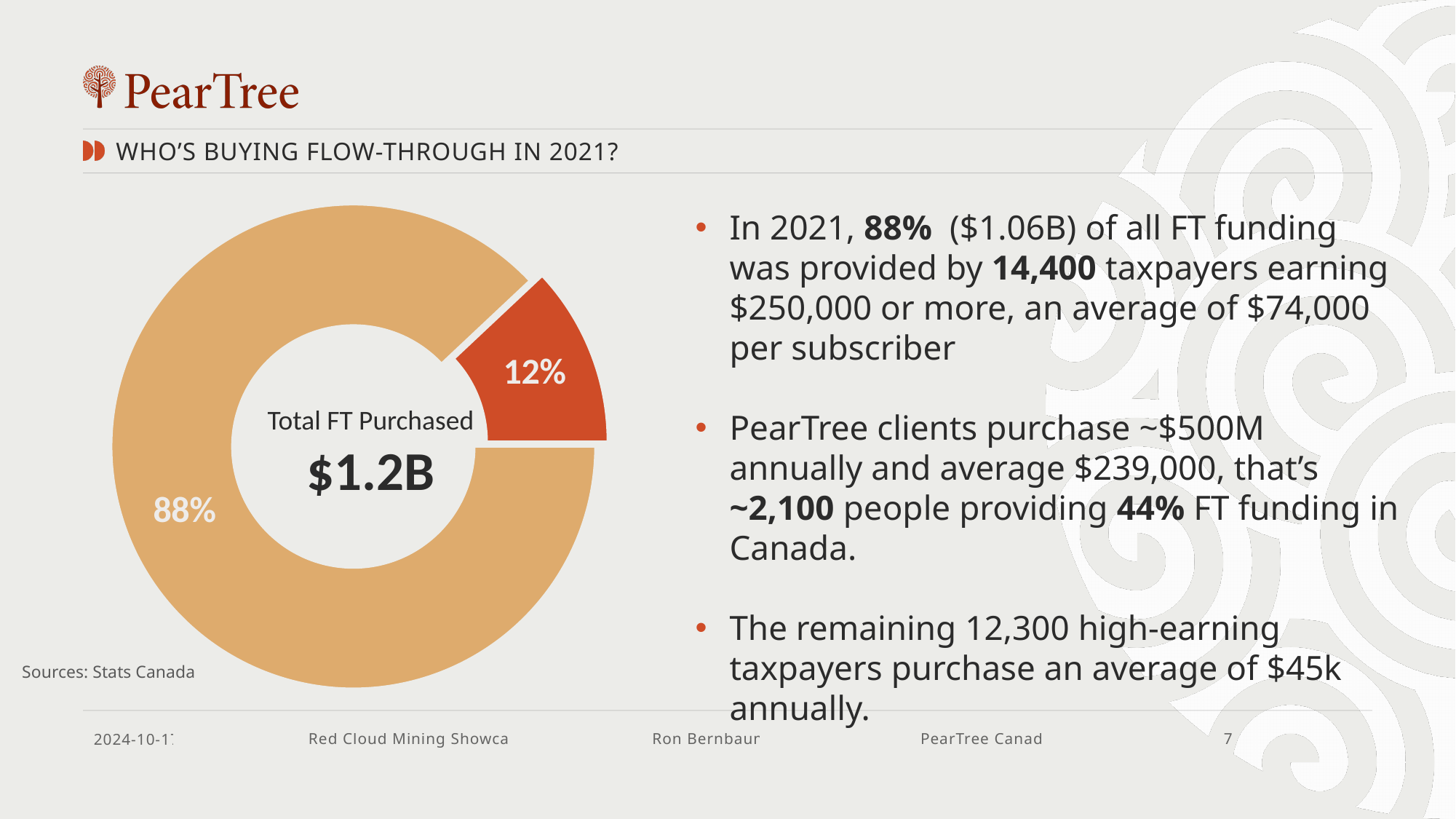
What percentage is shown on the smaller slice of the donut chart? 12% Is the share of the larger slice in the donut chart greater or less than 50%? greater How many slices does the donut chart have? 2 What percentage is shown on the larger slice of the donut chart? 88% What source is cited for the donut chart? Stats Canada What kind of chart is shown on the slide? Donut (pie) chart What share of the donut chart does the red-orange slice represent? 12% Which slice is larger in the donut chart, the tan slice or the red-orange slice? The tan slice What colour is the 12% slice of the donut chart? Red-orange What is the difference in percentage points between the two slices of the donut chart? 76 What label appears above the value in the centre of the donut chart? Total FT Purchased What total value is printed in the centre of the donut chart? $1.2B